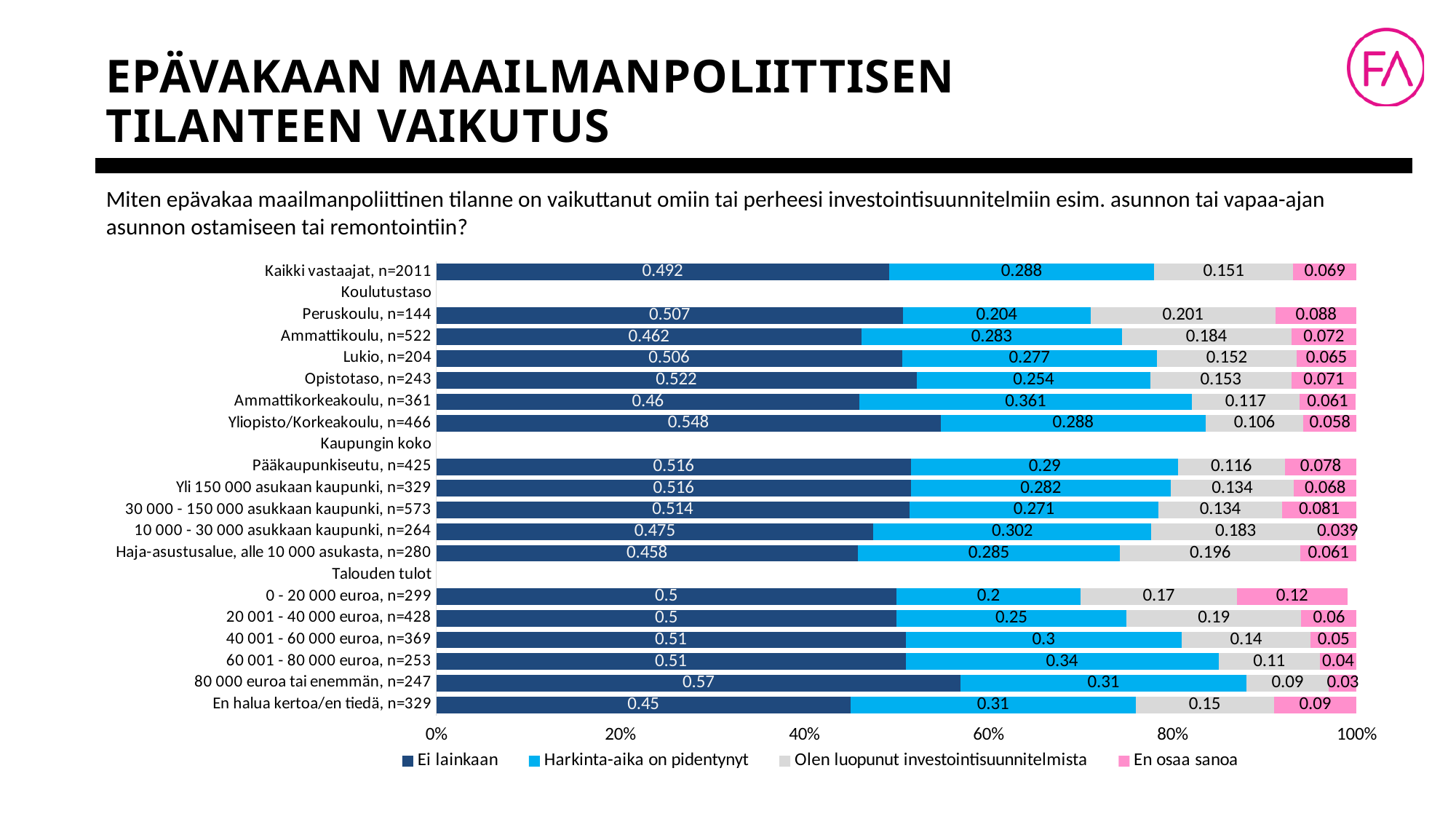
Which is larger: the "Ei lainkaan" value for Yliopisto/Korkeakoulu, n=466 or for Ammattikoulu, n=522? Yliopisto/Korkeakoulu, n=466 Which respondent group has the lowest value for "En osaa sanoa"? 80 000 euroa tai enemmän, n=247 Which respondent group has the highest value for "Olen luopunut investointisuunnitelmista"? Peruskoulu, n=144 How many series does the legend list? 4 What kind of chart is shown on the slide? Stacked horizontal bar chart What is the difference between the "Ei lainkaan" and "Harkinta-aika on pidentynyt" values for Kaikki vastaajat, n=2011? 0.204 What is the value of "Ei lainkaan" for Kaikki vastaajat, n=2011? 0.492 What is the value of "En osaa sanoa" for 0 - 20 000 euroa, n=299? 0.12 What colour represents the "En osaa sanoa" series? Pink What is the value of "Harkinta-aika on pidentynyt" for Ammattikorkeakoulu, n=361? 0.361 How many respondent groups have bars plotted in the chart? 18 Which respondent group has the highest value for "Ei lainkaan"? 80 000 euroa tai enemmän, n=247